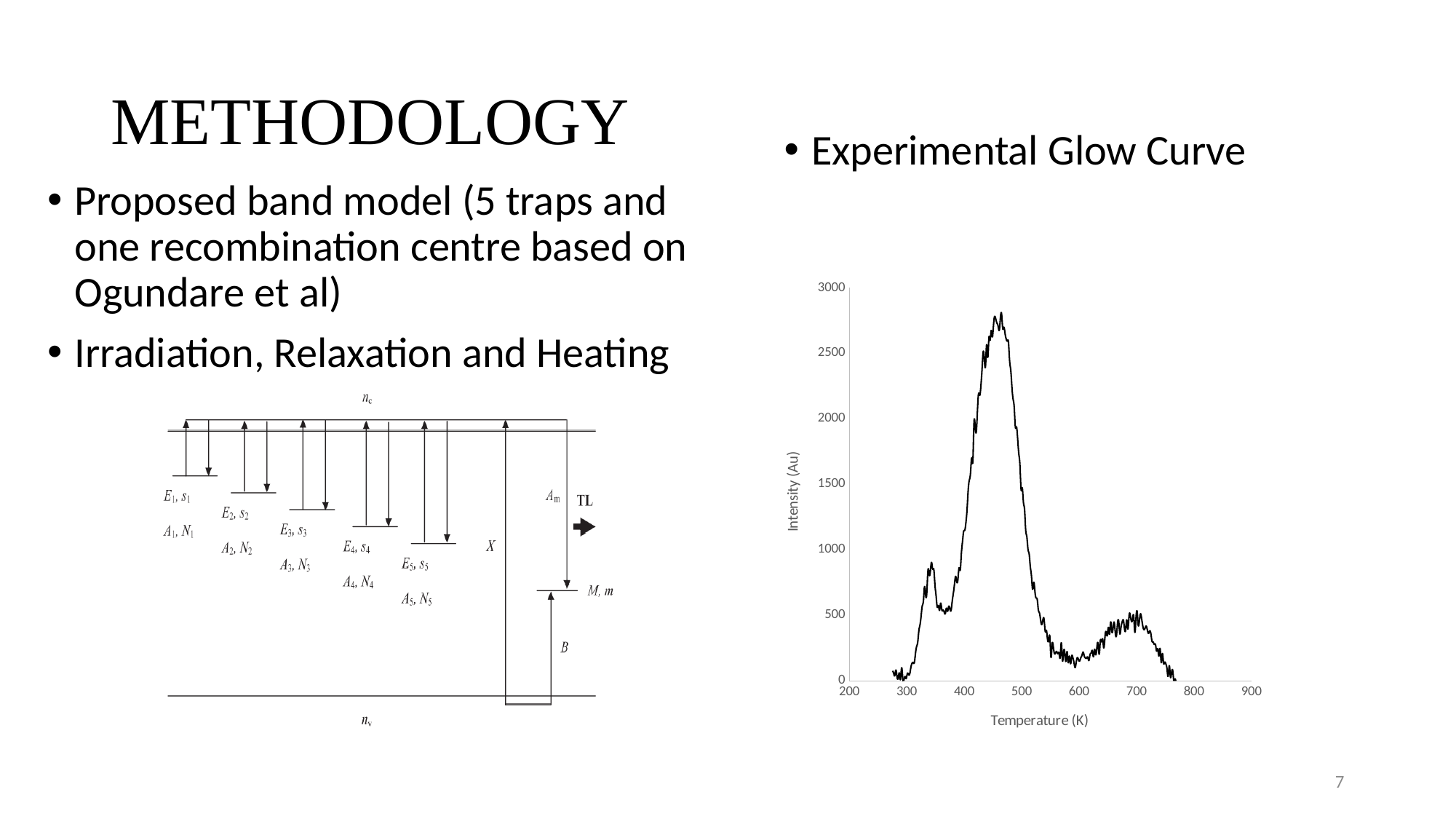
In the Experimental Glow Curve chart, is the maximum intensity of the curve greater or less than 2500? greater In the Experimental Glow Curve chart, which peak is higher: the one near 340 K or the one near 700 K? the one near 340 K In the Experimental Glow Curve chart, is the intensity at 550 K greater or less than 500? less In the Experimental Glow Curve chart, does the intensity rise or fall as temperature increases from 500 K to 600 K? fall In the Experimental Glow Curve chart, what is the label of the x axis? Temperature (K) In the Experimental Glow Curve chart, what is the label of the y axis? Intensity (Au) In the Experimental Glow Curve chart, is the intensity at 700 K greater or less than 1000? less What kind of chart is the Experimental Glow Curve on the right of the slide? line chart In the Experimental Glow Curve chart, which peak is higher: the one near 340 K or the one near 460 K? the one near 460 K In the Experimental Glow Curve chart, does the intensity rise or fall as temperature increases from 400 K to 460 K? rise